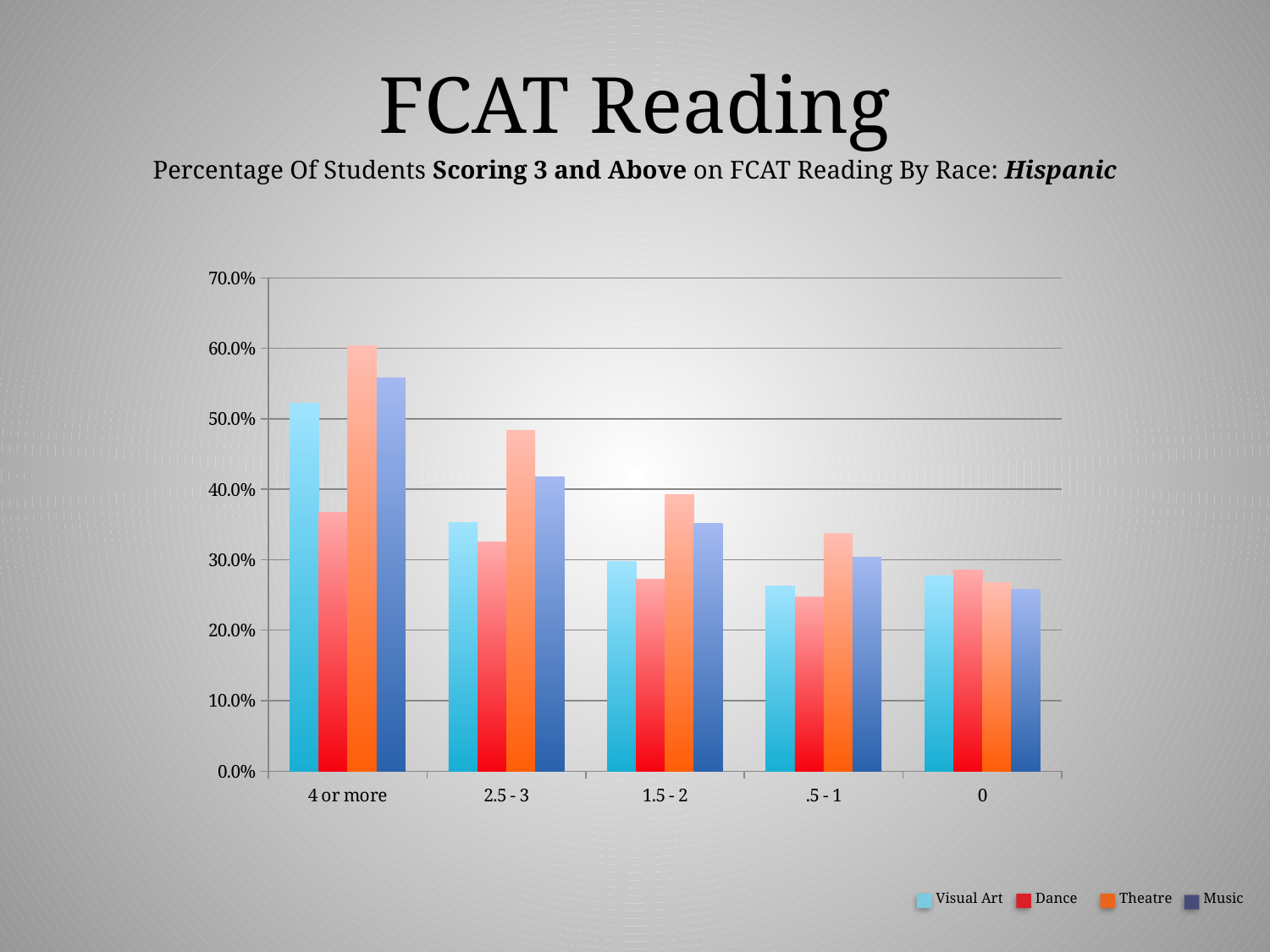
Which series has the lowest value in the '1.5 - 2' category? Dance Which race does the chart subtitle say the data is for? Hispanic How many series does the legend list? 4 What kind of chart is shown on the slide? bar chart Do the Theatre values rise or fall moving from '4 or more' to '0' along the x axis? fall For the '2.5 - 3' category, which is larger: Theatre or Dance? Theatre Is the Music value for the '2.5 - 3' category greater or less than 40.0%? greater For the '4 or more' category, which is larger: Visual Art or Music? Music Which category has the highest Theatre value? 4 or more Is the Theatre value for the '4 or more' category greater or less than 50.0%? greater Is the Dance value for the '4 or more' category greater or less than 40.0%? less How many categories are shown on the x axis? 5